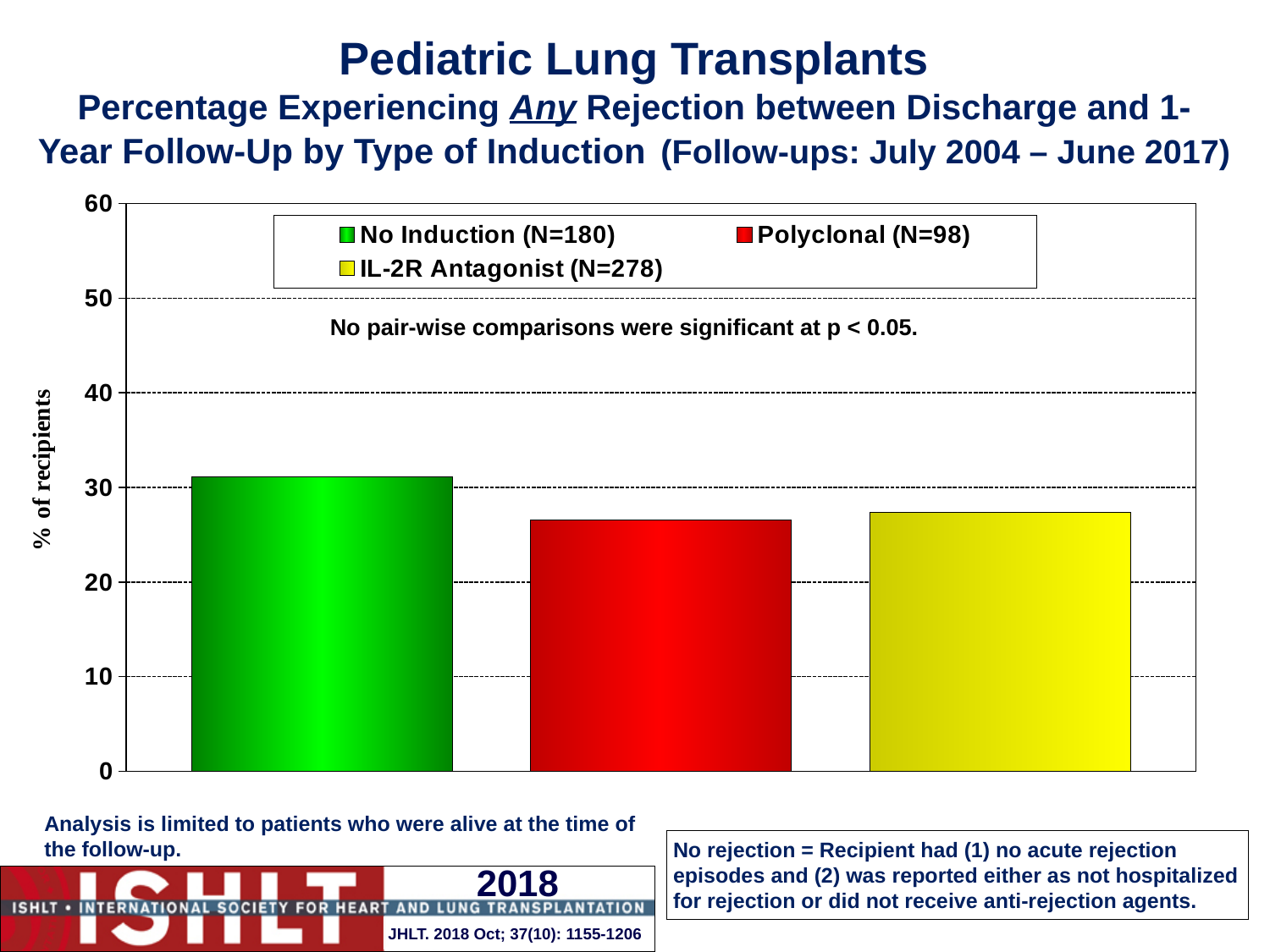
Which induction type has the highest percentage of recipients experiencing any rejection? No Induction Which is larger, the value for No Induction or the value for Polyclonal? No Induction Is the value for Polyclonal greater or less than 30? less What kind of chart is shown on the slide? bar chart How many bars are plotted in the chart? 3 Is the value for IL-2R Antagonist greater or less than 30? less Is the value for No Induction greater or less than 30? greater What is the sample size (N) shown in the legend for the IL-2R Antagonist group? 278 How many series does the legend list? 3 What is the label on the y axis of the chart? % of recipients